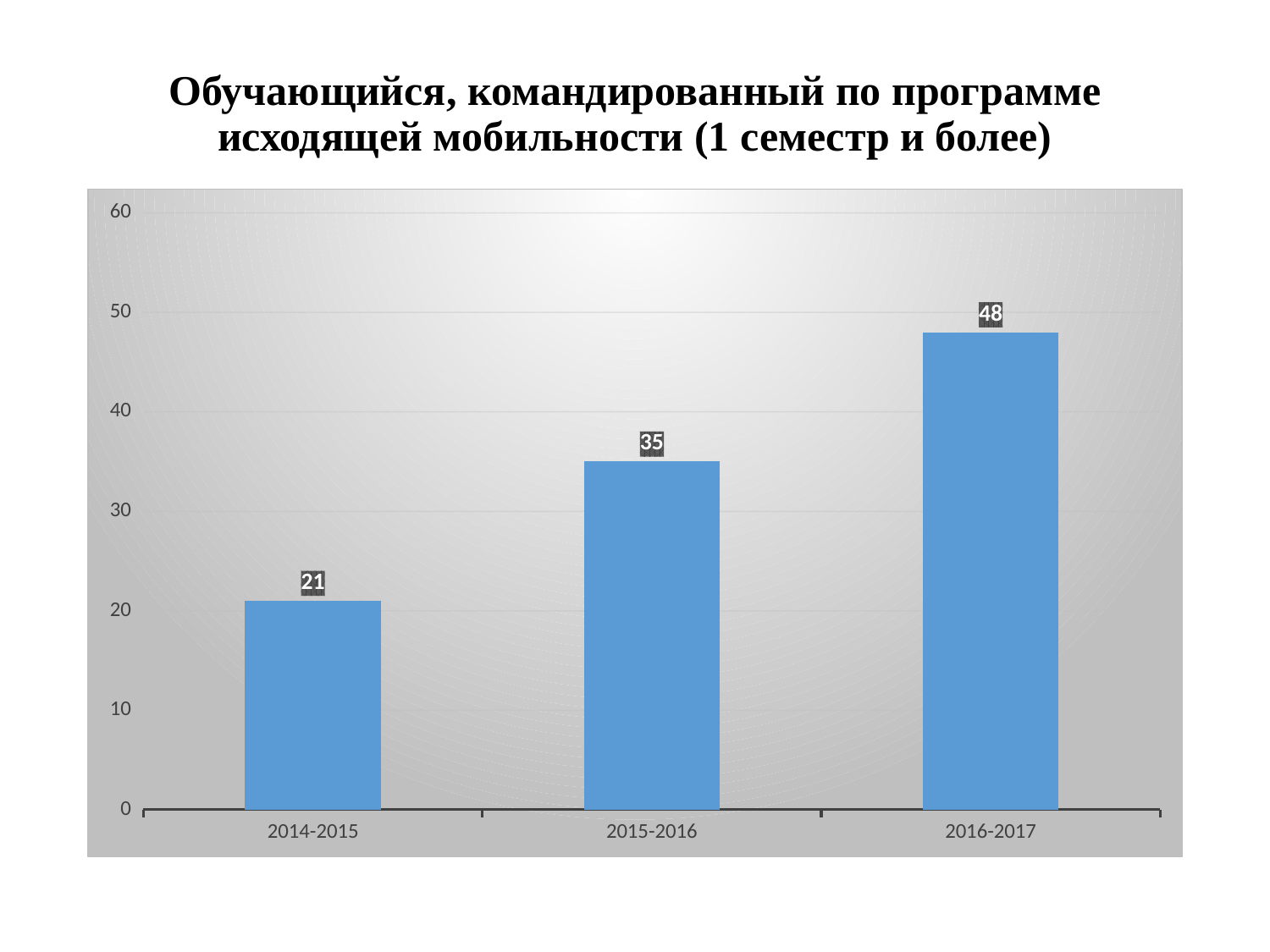
Which is larger, the value for 2015-2016 or the value for 2016-2017? 2016-2017 What is the value for 2014-2015? 21 What is the value for 2016-2017? 48 Is the value for 2016-2017 greater or less than 40? greater Do the values rise or fall from 2014-2015 to 2016-2017? rise What is the value for 2015-2016? 35 What is the difference between the values for 2016-2017 and 2014-2015? 27 How many academic years are shown on the x axis? 3 What kind of chart is shown on the slide? bar chart What is the difference between the values for 2015-2016 and 2014-2015? 14 Which academic year has the lowest value? 2014-2015 Which academic year has the highest value? 2016-2017